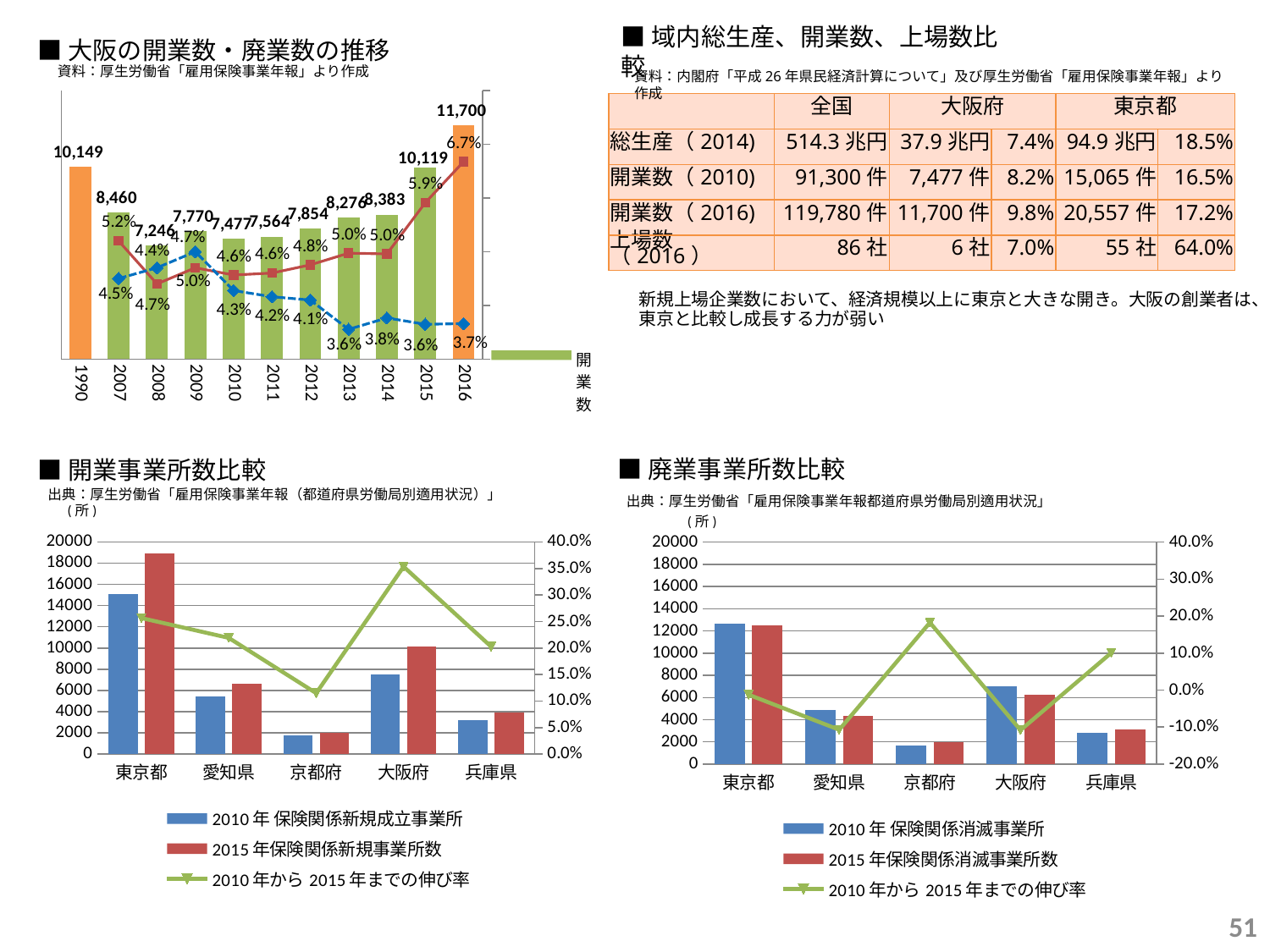
In the chart titled 大阪の開業数・廃業数の推移, what is the value of the bar for 1990? 10,149 In the chart titled 開業事業所数比較, is the value of the 2010年 保険関係新規成立事業所 bar for 大阪府 greater or less than 8000? less In the chart titled 大阪の開業数・廃業数の推移, how many years are shown on the x axis? 11 In the chart titled 廃業事業所数比較, which prefecture has the highest 2010年から2015年までの伸び率? 京都府 In the chart titled 大阪の開業数・廃業数の推移, which year has the highest bar value? 2016 In the chart titled 開業事業所数比較, which prefecture has the highest 2010年から2015年までの伸び率? 大阪府 In the chart titled 大阪の開業数・廃業数の推移, is the bar value for 2013 larger or smaller than the bar value for 2014? smaller In the chart titled 大阪の開業数・廃業数の推移, what is the difference between the bar values for 2016 and 2015? 1,581 In the chart titled 廃業事業所数比較, how many series does the legend list? 3 In the chart titled 大阪の開業数・廃業数の推移, what is the value of the bar for 2016? 11,700 In the chart titled 大阪の開業数・廃業数の推移, which year has the lowest bar value? 2008